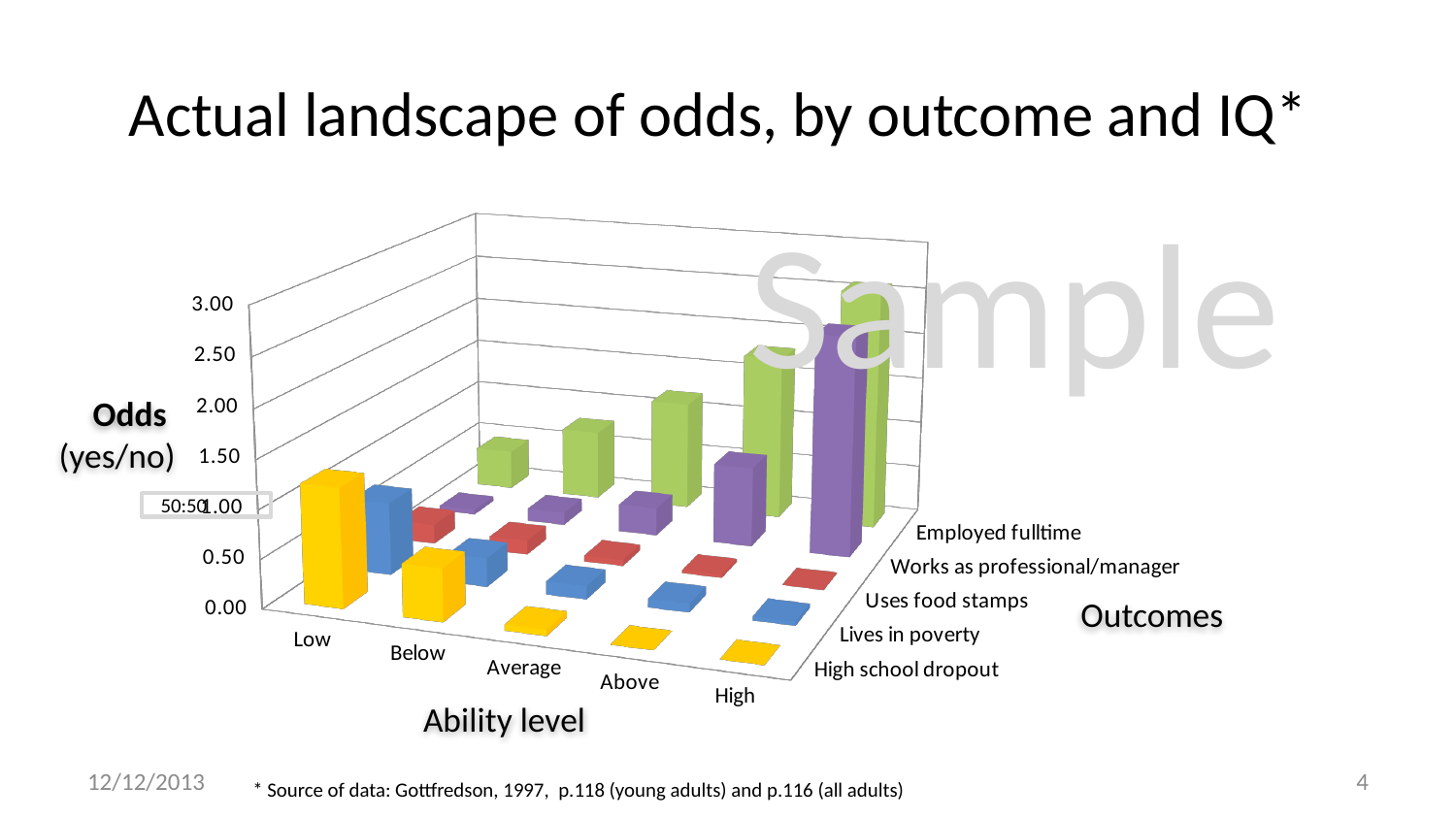
What kind of chart is shown on the slide? 3D bar chart Do the odds for Employed fulltime rise or fall as ability level goes from Low to High? rise Is the value for Employed fulltime at the High ability level greater or less than 2.00? greater How many ability levels are shown along the Ability level axis? 5 What is the title of the chart on the slide? Actual landscape of odds, by outcome and IQ* Which ability level has the lowest odds for Employed fulltime? Low How many outcomes are plotted in the chart? 5 What label is attached to the 1.00 tick on the Odds axis? 50:50 Which ability level has the highest odds for High school dropout? Low Do the odds for High school dropout rise or fall as ability level goes from Low to High? fall Which ability level has the highest odds for Employed fulltime? High Which is larger: the odds for Works as professional/manager at the High ability level or at the Low ability level? High